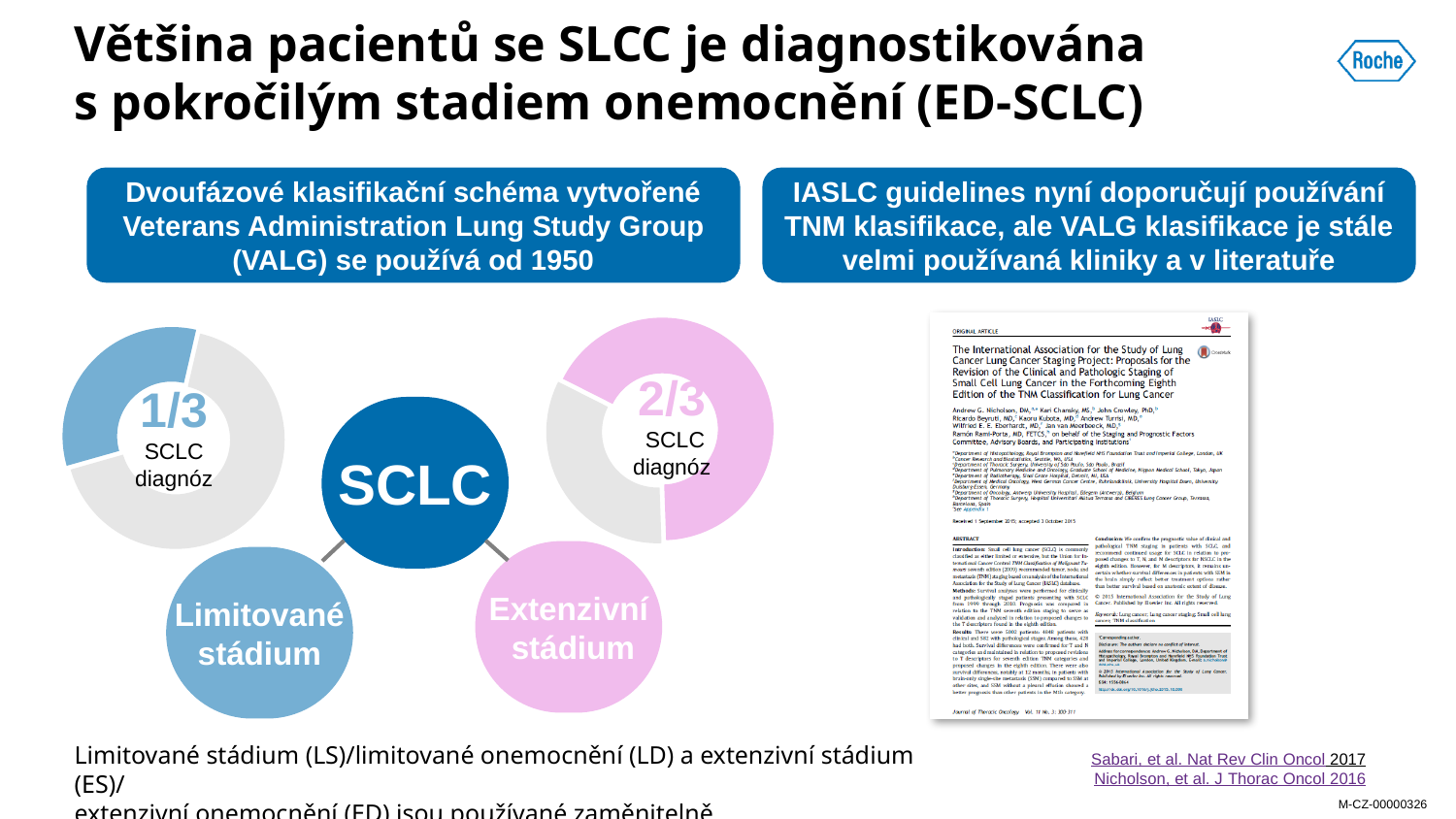
What colour is the highlighted slice in the right donut chart for Extenzivní stádium? Pink Which stage accounts for the smaller share of SCLC diagnoses? Limitované stádium What colour is the highlighted slice in the left donut chart for Limitované stádium? Light blue Which stage accounts for the larger share of SCLC diagnoses, Limitované stádium or Extenzivní stádium? Extenzivní stádium Is the share of SCLC diagnoses for Limitované stádium greater or less than half? less How many donut charts are shown on the slide? 2 What share of SCLC diagnoses does the left donut chart (Limitované stádium) show? 1/3 What share of SCLC diagnoses does the right donut chart (Extenzivní stádium) show? 2/3 Is the share of SCLC diagnoses for Extenzivní stádium greater or less than half? greater What kind of chart is used to show the share of SCLC diagnoses for each stage? Pie (donut) chart